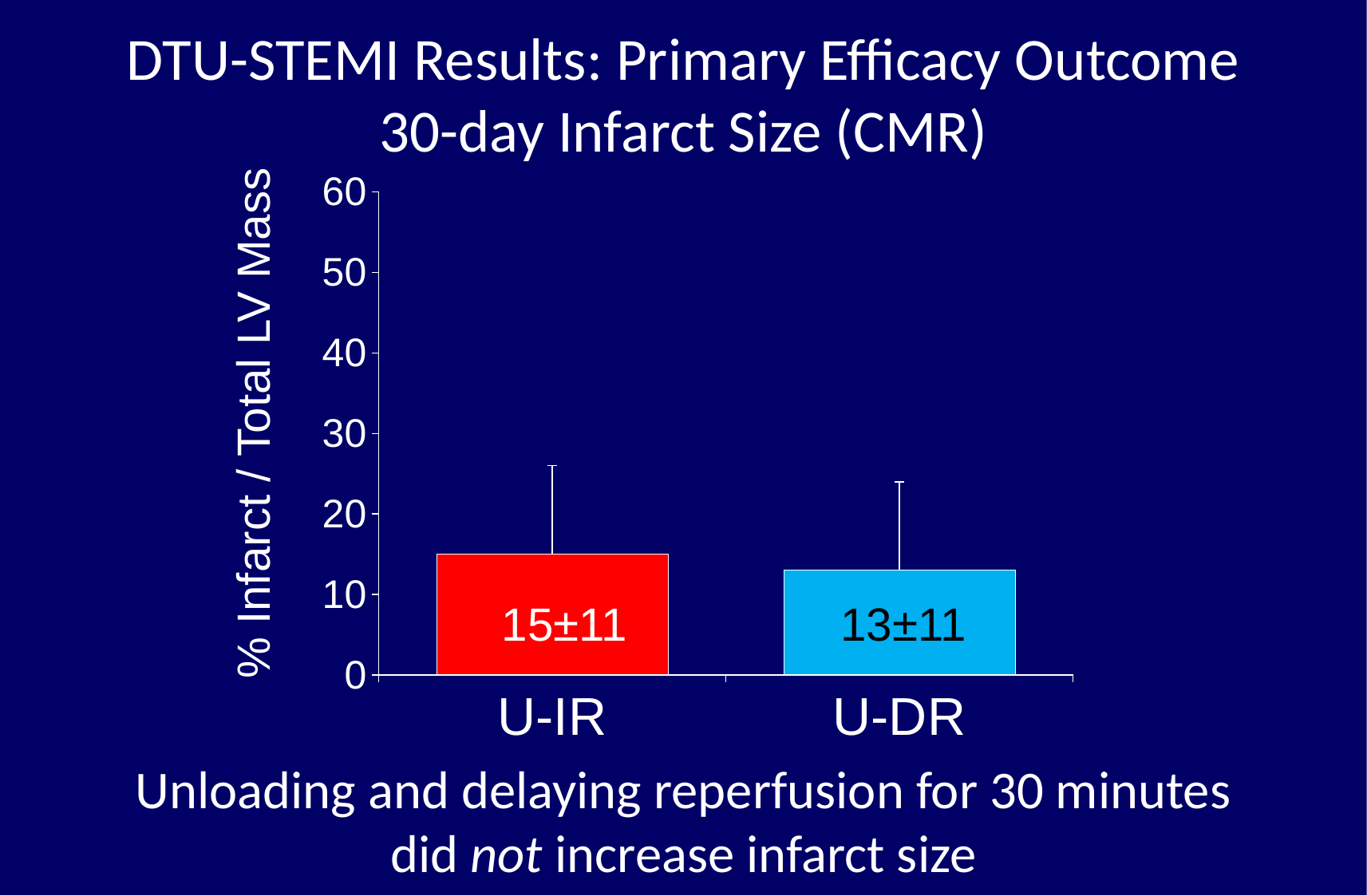
What kind of chart is shown on the slide? bar chart What is the data label shown on the U-IR bar? 15±11 What is the label of the y axis? % Infarct / Total LV Mass Which group has the smaller 30-day infarct size? U-DR What is the maximum value shown on the y axis? 60 Is the mean infarct size for U-DR greater or less than 10? greater How many groups are plotted on the x axis? 2 Is the mean infarct size for U-IR greater or less than 20? less What is the data label shown on the U-DR bar? 13±11 Which group has the larger 30-day infarct size? U-IR What is the difference between the mean infarct size of U-IR and U-DR? 2 What colour is the U-DR bar? light blue